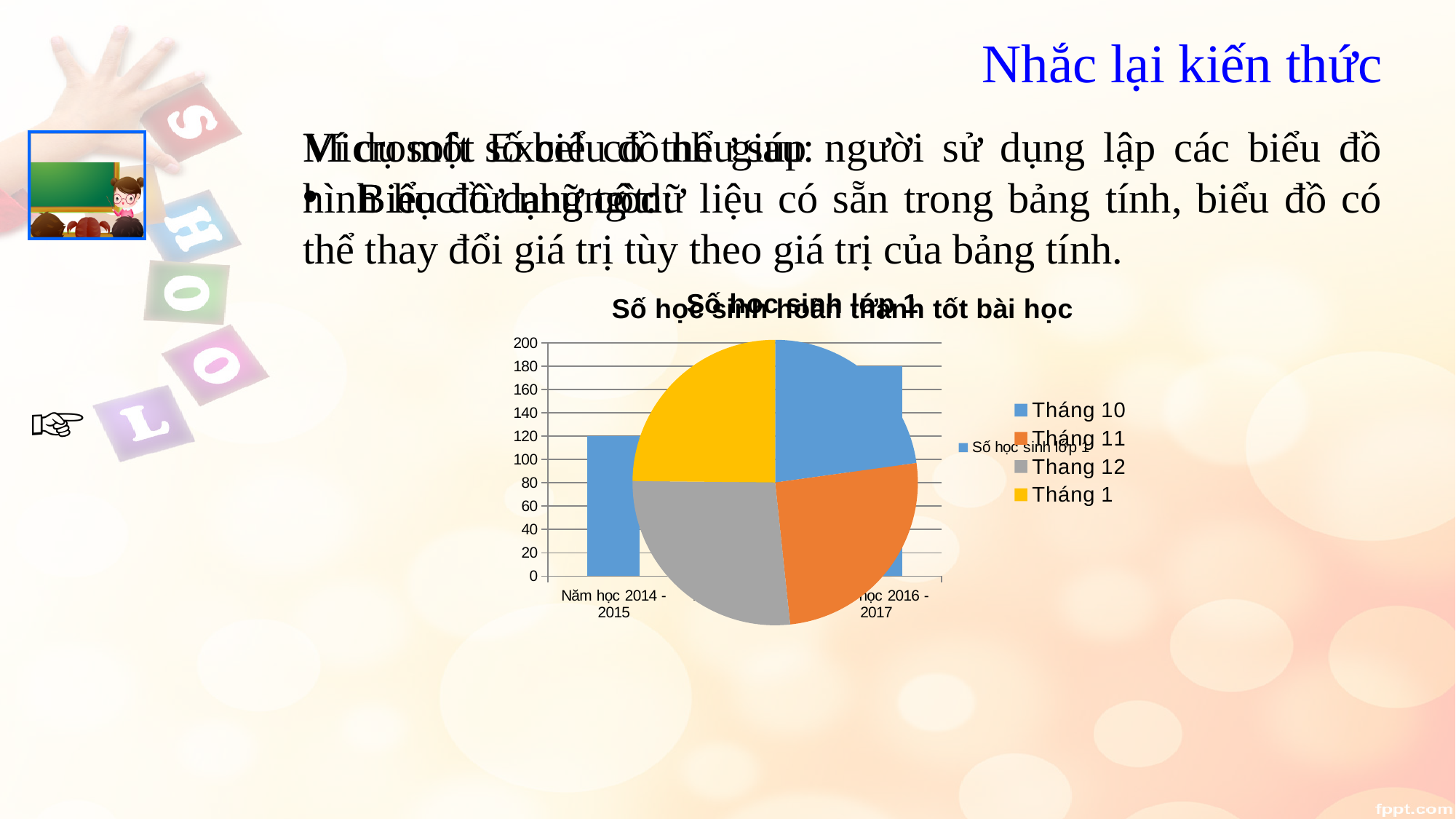
In the chart titled "Số học sinh hoàn thành tốt bài học", how many slices does the pie have? 4 In the chart titled "Số học sinh hoàn thành tốt bài học", what colour is the slice for Tháng 1? yellow In the chart titled "Số học sinh hoàn thành tốt bài học", what kind of chart is it? pie chart In the chart titled "Số học sinh lớp 1", which is larger: the value for Năm học 2014 - 2015 or Năm học 2016 - 2017? Năm học 2016 - 2017 In the chart titled "Số học sinh lớp 1", how many series does the legend list? 1 In the chart titled "Số học sinh lớp 1", what kind of chart is it? bar chart In the chart titled "Số học sinh lớp 1", is the value for Năm học 2014 - 2015 greater or less than 140? less In the chart titled "Số học sinh lớp 1", is the value for Năm học 2016 - 2017 greater or less than 160? greater In the chart titled "Số học sinh lớp 1", what is the difference between the values for Năm học 2016 - 2017 and Năm học 2014 - 2015? 60 In the chart titled "Số học sinh hoàn thành tốt bài học", how many entries does the legend list? 4 In the chart titled "Số học sinh lớp 1", what is the value for Năm học 2014 - 2015? 120 In the chart titled "Số học sinh lớp 1", what is the value for Năm học 2016 - 2017? 180